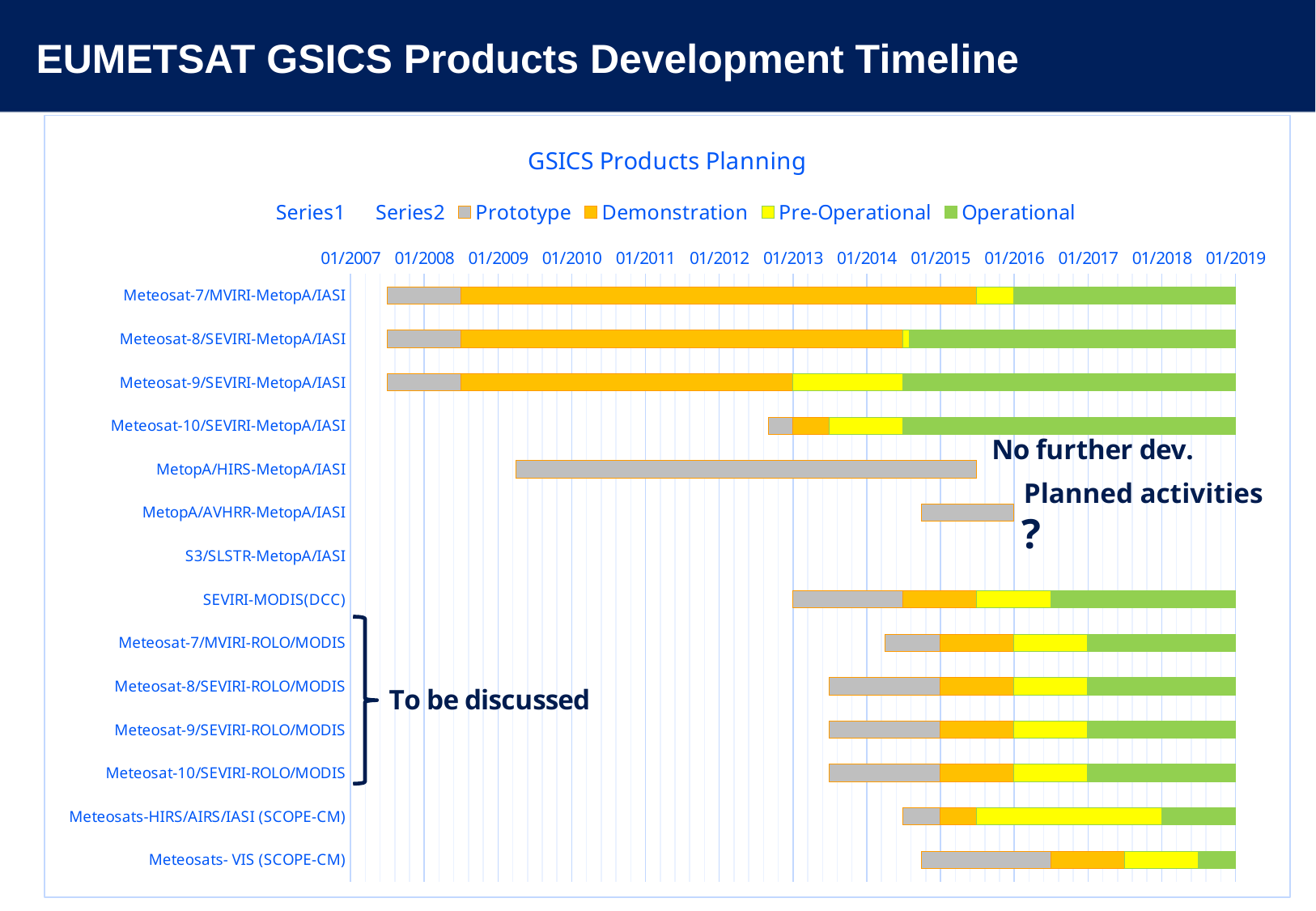
What is the title of the chart? GSICS Products Planning How many product rows (categories) are listed on the vertical axis of the chart? 14 Does the bar for SEVIRI-MODIS(DCC) begin before or after 01/2014? before Does the bar for Meteosat-10/SEVIRI-MetopA/IASI begin before or after 01/2012? after What kind of chart is shown on the slide? bar chart What is the first date tick shown on the horizontal axis? 01/2007 Does the bar for MetopA/HIRS-MetopA/IASI begin before or after 01/2010? before How many product rows show only a grey Prototype segment and no other phase? 2 Which product row has no bar plotted at all? S3/SLSTR-MetopA/IASI What is the last date tick shown on the horizontal axis? 01/2019 How many entries does the chart legend list? 6 Which ends earlier, the bar for MetopA/HIRS-MetopA/IASI or the bar for MetopA/AVHRR-MetopA/IASI? MetopA/HIRS-MetopA/IASI